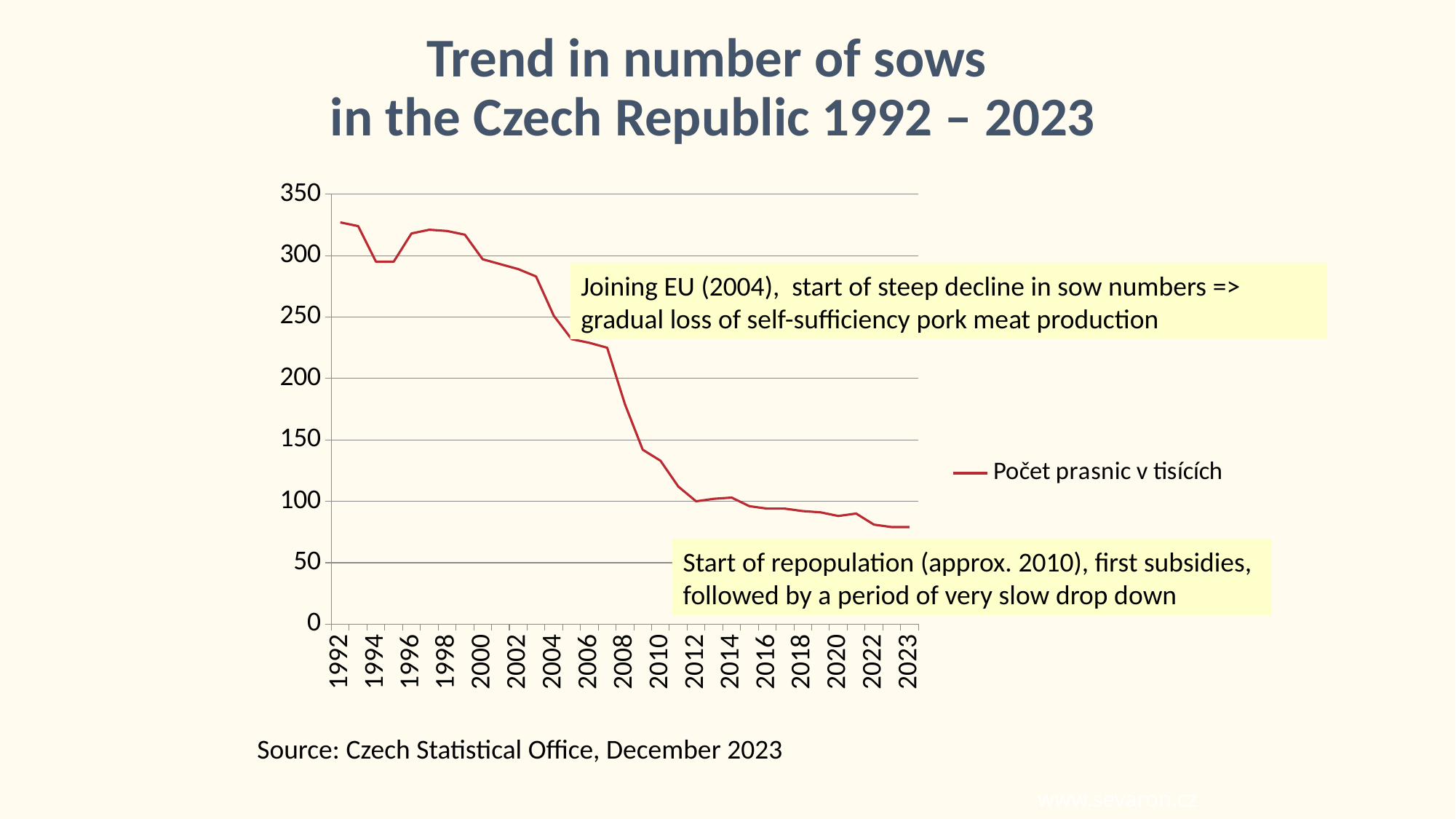
Is the value for 2010 greater or less than 100? greater Is the value for 2004 greater or less than 300? less Is the value for 2008 greater or less than 200? less Overall, do the values rise or fall from 1992 to 2023? fall What is the legend entry for the plotted series? Počet prasnic v tisících How many series does the legend list? 1 Which year has the larger value, 1992 or 2023? 1992 What kind of chart is shown on the slide? line chart Which year has the larger value, 1994 or 1998? 1998 What is the title of the chart on the slide? Trend in number of sows in the Czech Republic 1992 – 2023